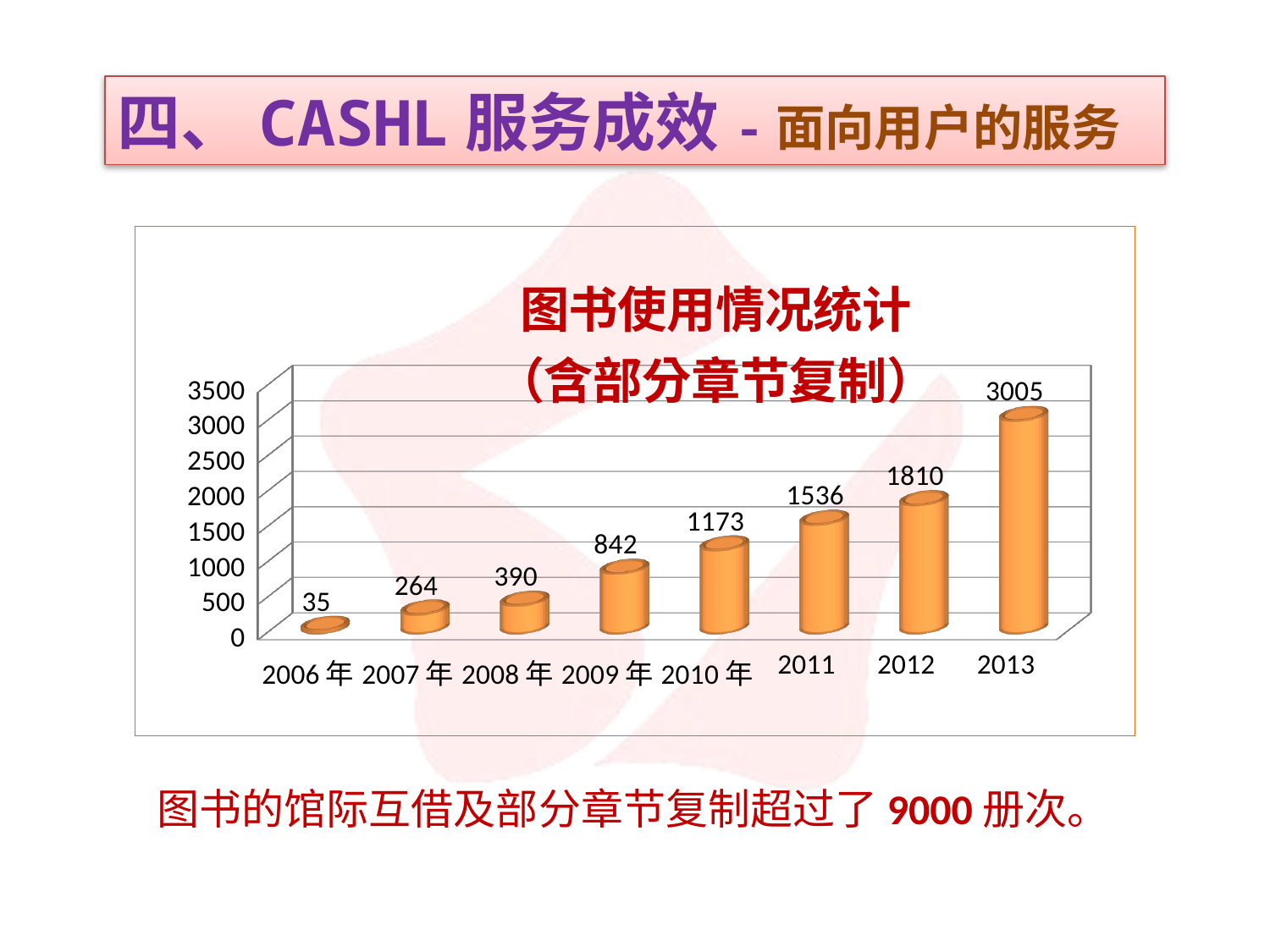
What is the difference between the values for 2013 and 2012? 1195 What is the value for 2006年? 35 Do the values rise or fall from 2006年 to 2013? rise Which year has the highest value? 2013 What kind of chart is this? bar chart Which is larger, the value for 2008年 or the value for 2007年? 2008年 How many years are shown on the x axis? 8 What is the difference between the values for 2011 and 2010年? 363 Which year has the lowest value? 2006年 What is the value for 2009年? 842 What is the title of the chart? 图书使用情况统计（含部分章节复制） What is the value for 2013? 3005